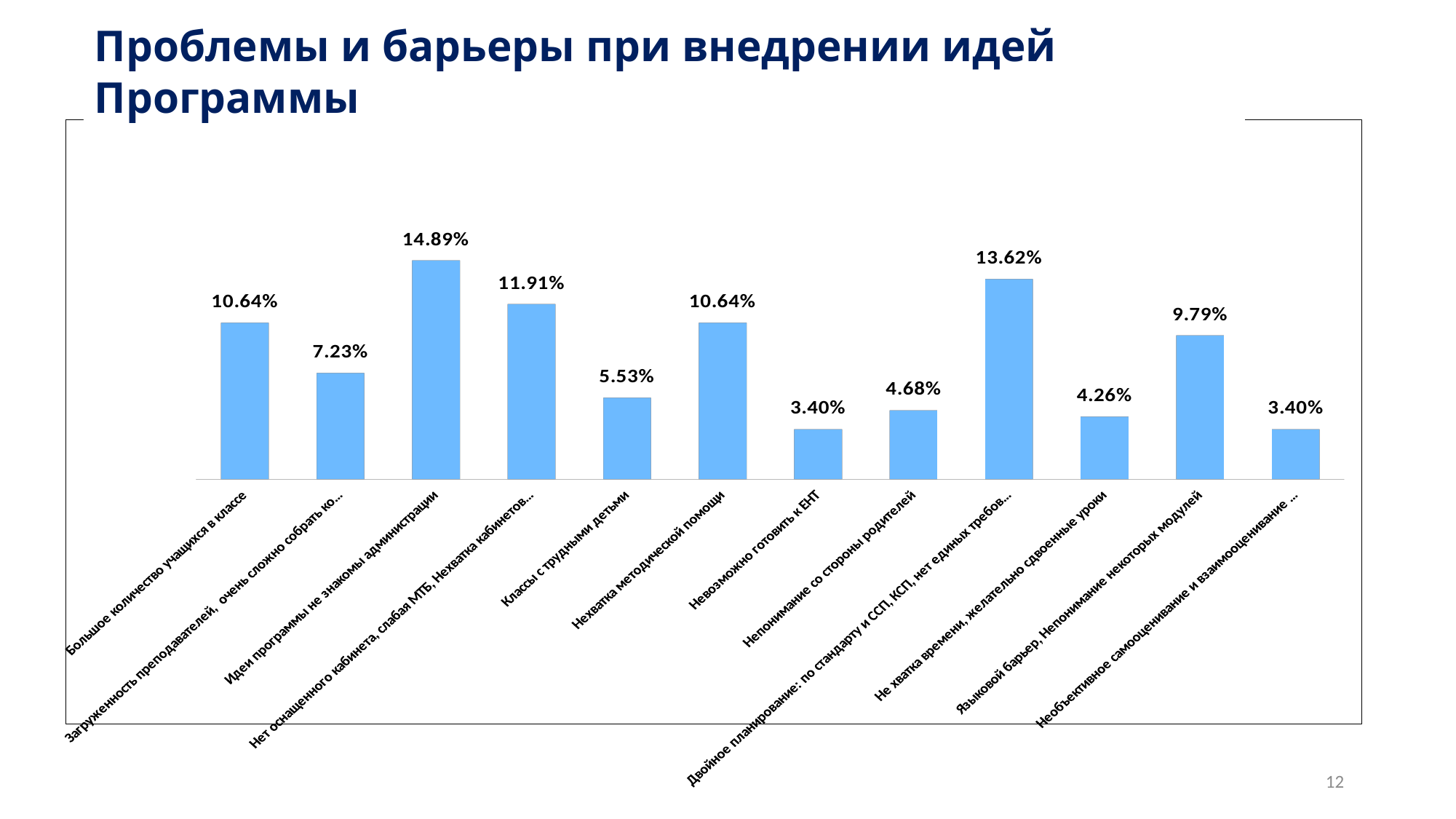
What is the value for "Языковой барьер, Непонимание некоторых модулей"? 9.79% Which category has the highest value? Идеи программы не знакомы администрации What is the value for "Классы с трудными детьми"? 5.53% What is the difference between the values for "Нехватка методической помощи" and "Классы с трудными детьми"? 5.11 percentage points What is the difference between the values for "Идеи программы не знакомы администрации" and "Нехватка методической помощи"? 4.25 percentage points Which is larger: the value for "Не хватка времени, желательно сдвоенные уроки" or the value for "Непонимание со стороны родителей"? Непонимание со стороны родителей How many categories are shown in the chart? 12 What is the lowest value shown in the chart? 3.40% What is the value for "Идеи программы не знакомы администрации"? 14.89% What is the value for "Непонимание со стороны родителей"? 4.68% What is the value for "Невозможно готовить к ЕНТ"? 3.40% What kind of chart is shown on the slide? Bar chart